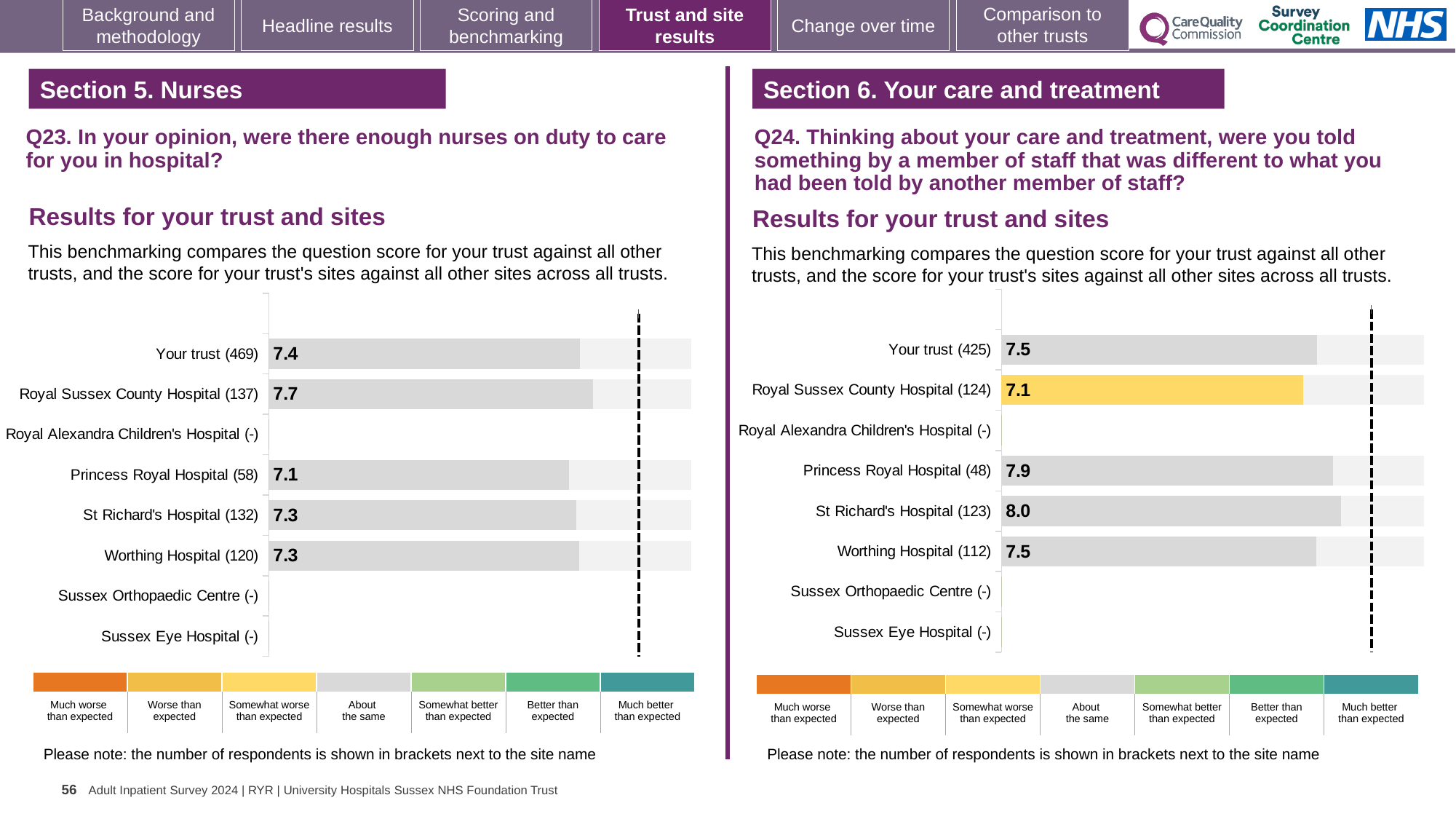
In the Q23 chart on the left, which site has the lowest score? Princess Royal Hospital In the Q24 chart on the right, what is the score for St Richard's Hospital? 8.0 In the Q24 chart on the right, which site has the highest score? St Richard's Hospital In the Q23 chart on the left, what is the score for Your trust? 7.4 In the Q24 chart on the right, which is larger: the score for Princess Royal Hospital or the score for Worthing Hospital? Princess Royal Hospital In the Q23 chart on the left, what is the score for Royal Sussex County Hospital? 7.7 In the Q23 chart on the left, what is the difference between the scores for Royal Sussex County Hospital and Princess Royal Hospital? 0.6 In the Q23 chart on the left, how many respondents are shown for St Richard's Hospital? 132 In the Q24 chart on the right, which site has the lowest score? Royal Sussex County Hospital In the Q24 chart on the right, how many row labels are listed on the vertical axis? 8 In the Q24 chart on the right, what is the difference between the scores for St Richard's Hospital and Royal Sussex County Hospital? 0.9 What kind of chart is used for the Q23 results on the left? Bar chart